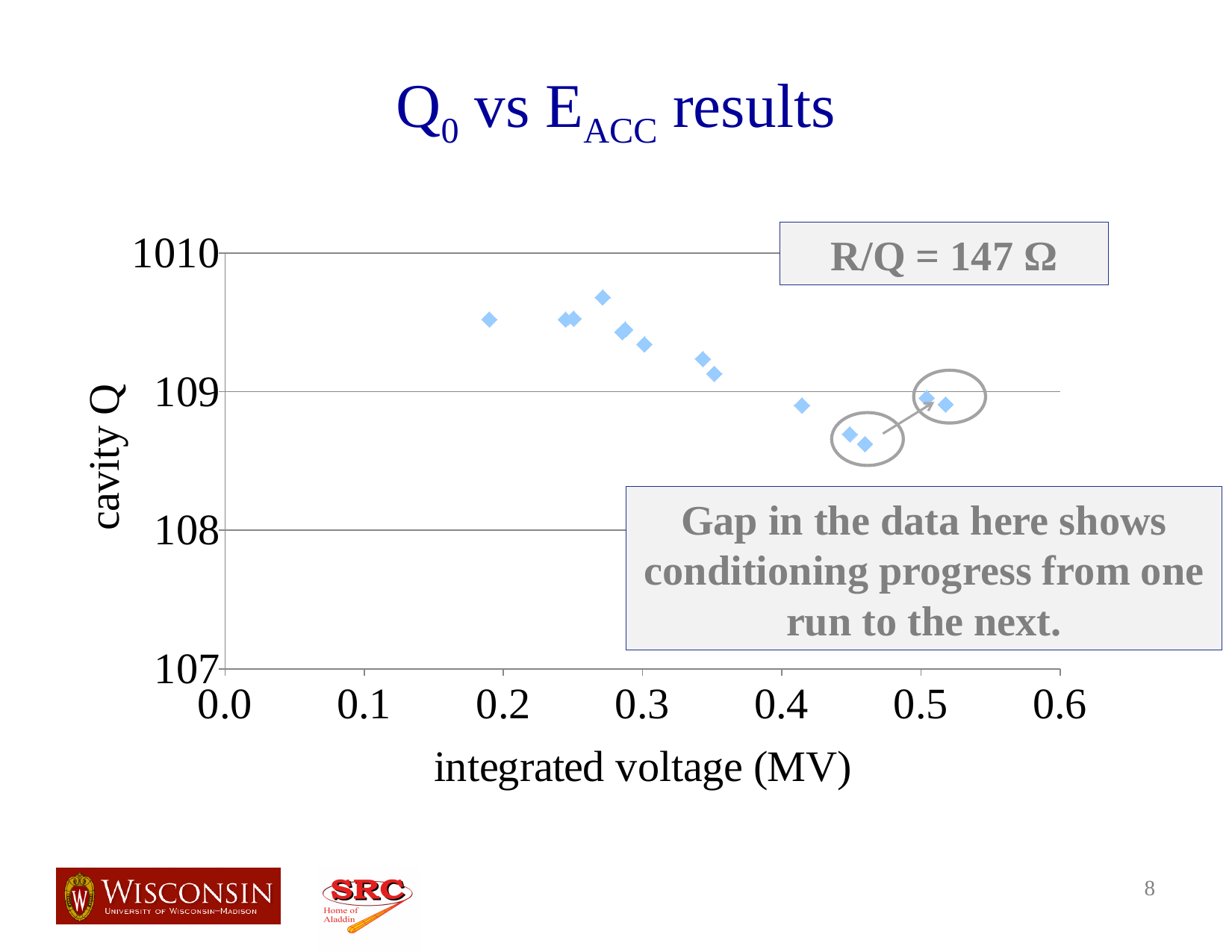
What is the lowest tick value shown on the y axis? 107 Is the cavity Q of the points near 0.5 MV greater or less than the 108 gridline? greater Which has the higher cavity Q: the point near 0.2 MV or the point near 0.46 MV? the point near 0.2 MV What is the title of the slide's chart? Q0 vs EACC results What is the label of the x axis? integrated voltage (MV) What value of R/Q is stated in the box on the chart? 147 Ω What kind of chart is shown on the slide? scatter chart Does cavity Q rise or fall as integrated voltage increases along the x axis? fall Is the cavity Q of the leftmost point (near 0.2 MV) greater or less than the 109 gridline? greater Is the cavity Q of the points near 0.45 MV greater or less than the 109 gridline? less What is the largest value shown on the x axis? 0.6